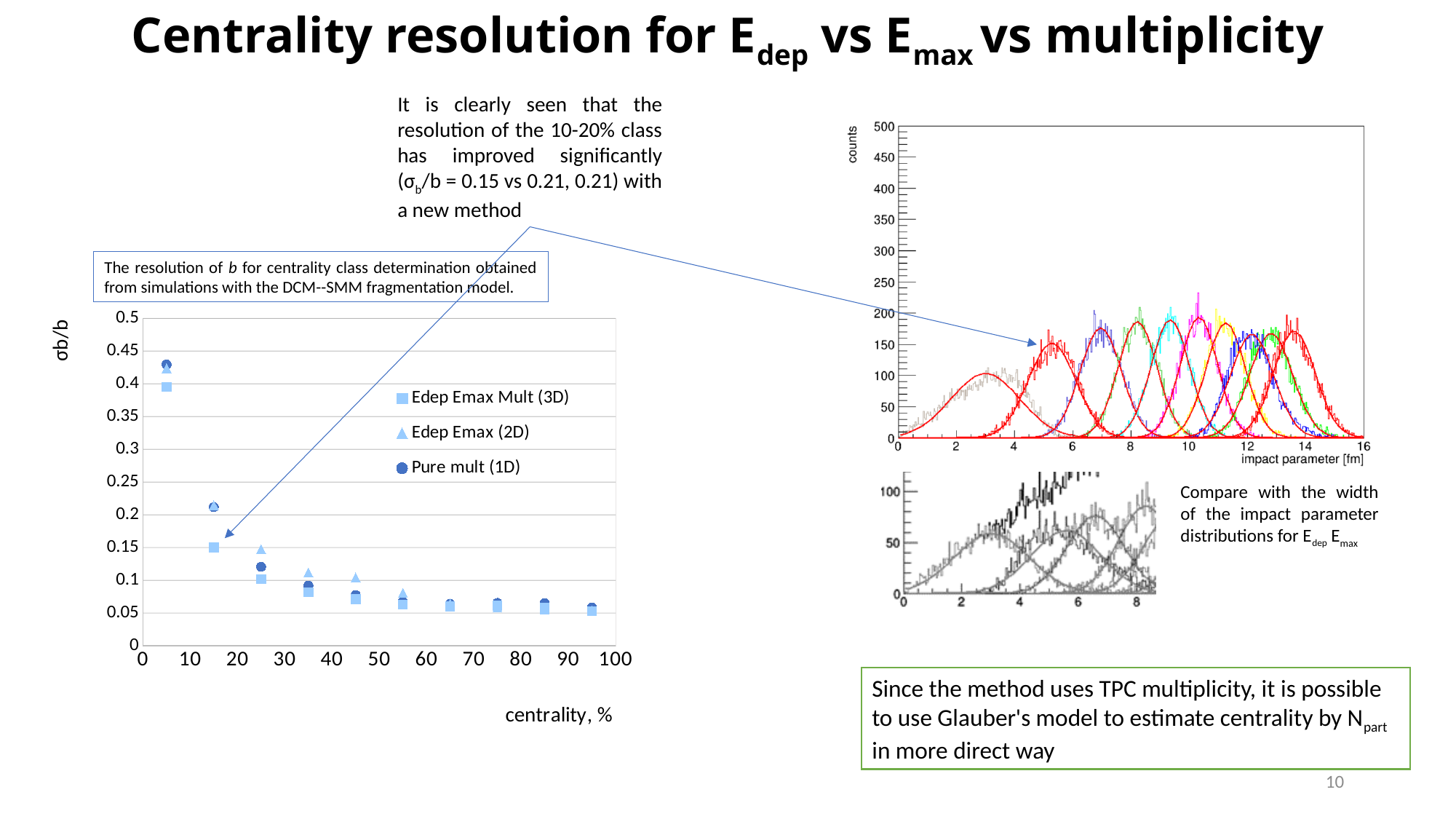
In the σb/b chart, at centrality 35, which series has the larger value: Edep Emax (2D) or Edep Emax Mult (3D)? Edep Emax (2D) How many series does the legend of the σb/b chart list? 3 What kind of chart is the left chart showing σb/b versus centrality? scatter chart According to the annotation on the slide, what is σb/b for the 10-20% class with the new method? 0.15 In the σb/b chart, at which centrality value does the Pure mult (1D) series reach its highest σb/b? 5 How many data points does the Edep Emax Mult (3D) series have in the σb/b chart? 10 In the σb/b chart, do the values rise or fall as centrality increases? fall In the σb/b chart, is the Pure mult (1D) value at centrality 15 greater or less than 0.2? greater In the σb/b chart, is the Pure mult (1D) value at centrality 45 greater or less than 0.1? less What is the x-axis label of the upper right histogram chart? impact parameter [fm] In the σb/b chart, is the Pure mult (1D) value at centrality 5 greater or less than 0.4? greater In the σb/b chart, at centrality 15, which series has the larger value: Pure mult (1D) or Edep Emax Mult (3D)? Pure mult (1D)